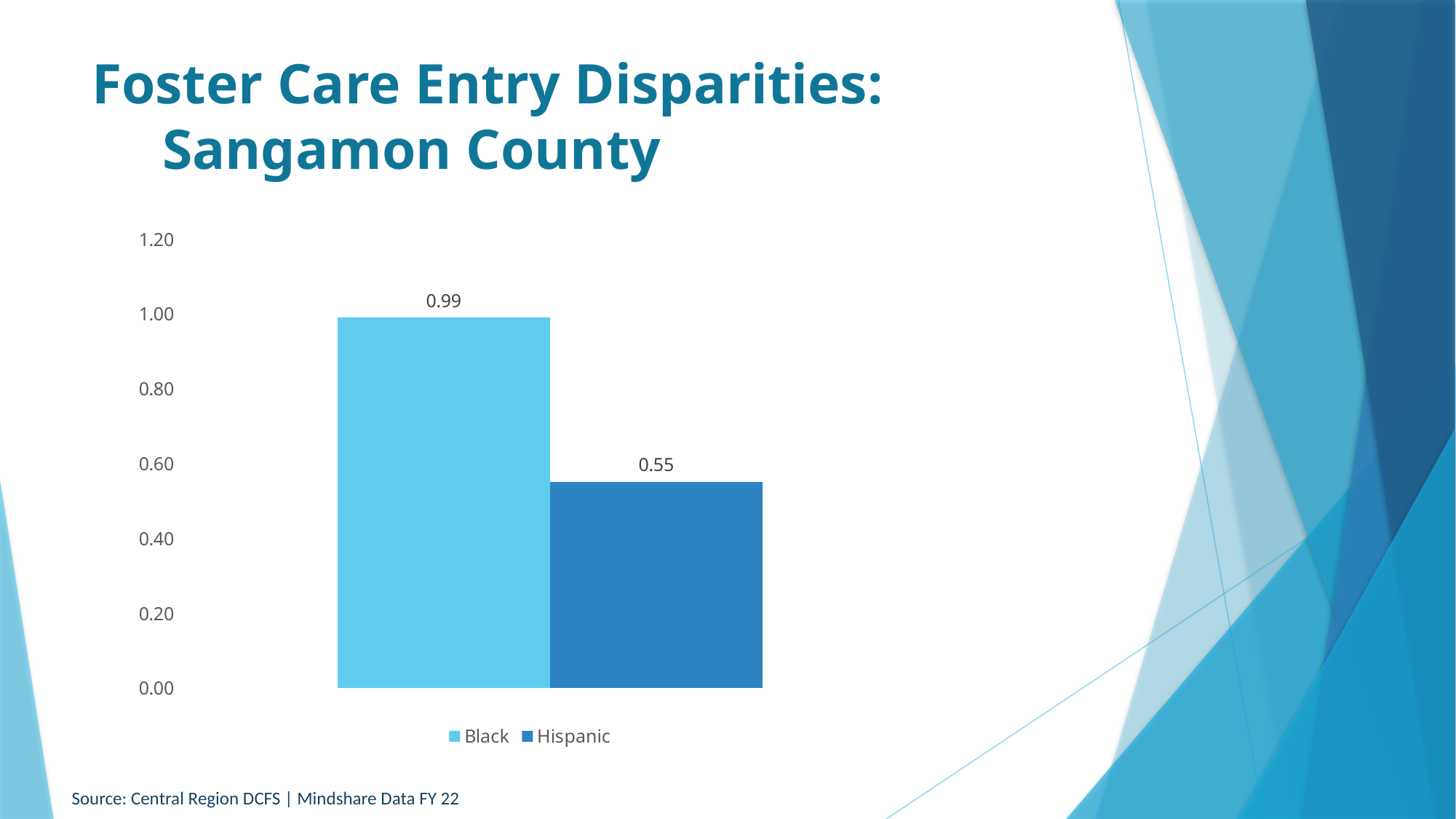
How many series does the legend list? 2 Which is larger, the value for Black or the value for Hispanic? Black How many bars are plotted on the chart? 2 What is the difference between the values for Black and Hispanic? 0.44 What is the value for Black? 0.99 Is the value for Black greater or less than 0.80? greater What kind of chart is shown on the slide? bar chart What is the value for Hispanic? 0.55 Which series has the highest value? Black What is the title of the slide? Foster Care Entry Disparities: Sangamon County Is the value for Hispanic greater or less than 0.60? less Which series has the lowest value? Hispanic